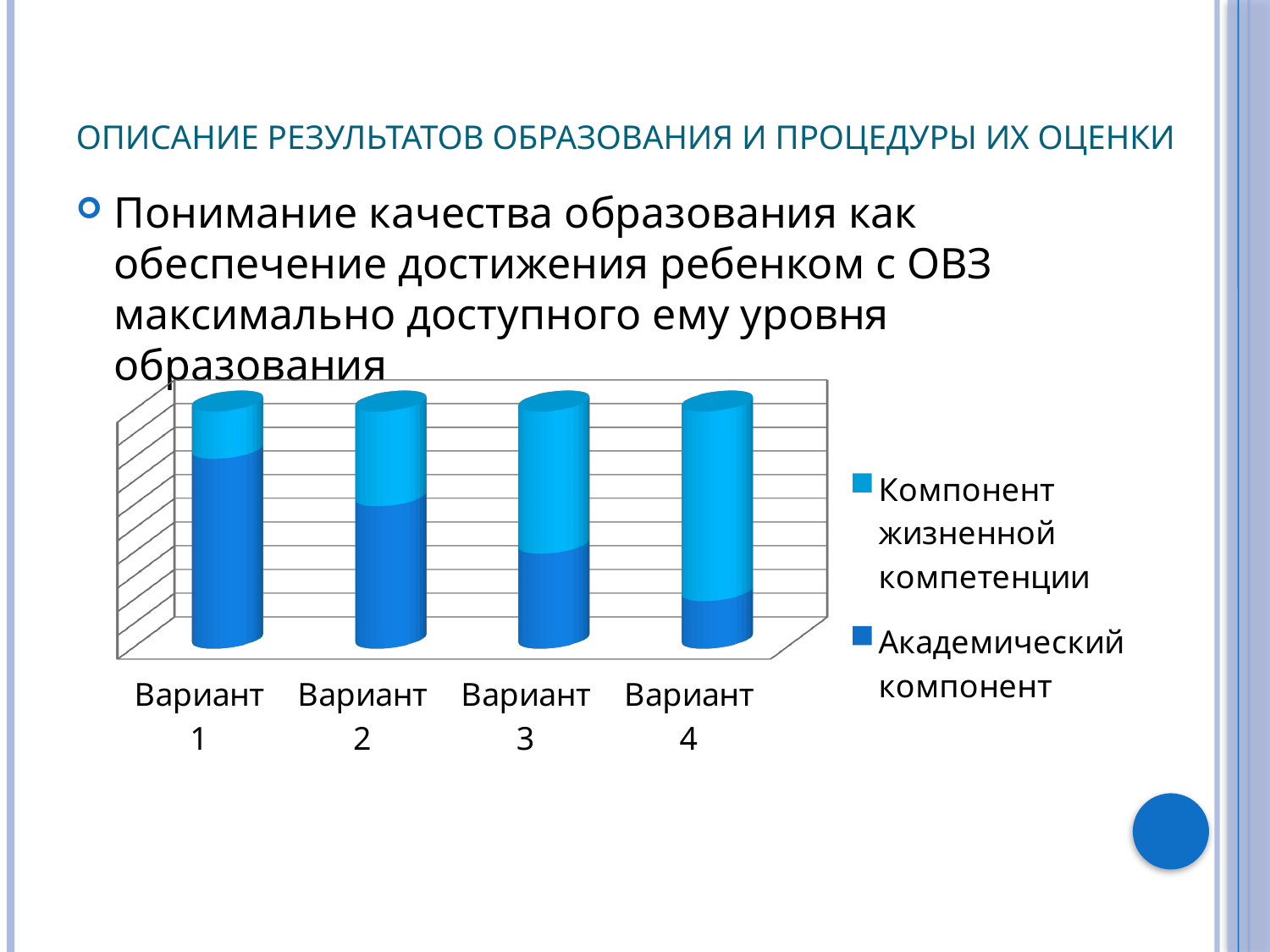
Does the Компонент жизненной компетенции segment rise or fall from Вариант 1 to Вариант 4? Rise What is the name of the series shown in light blue at the top of each bar? Компонент жизненной компетенции What kind of chart is shown on the slide? Stacked bar chart How many series does the chart legend list? 2 Which variant has the largest Академический компонент segment? Вариант 1 Which variant has the smallest Компонент жизненной компетенции segment? Вариант 1 Does the Академический компонент segment rise or fall from Вариант 1 to Вариант 4? Fall How many categories (variants) are shown on the x axis of the chart? 4 Is the Академический компонент segment larger in Вариант 2 or in Вариант 3? Вариант 2 Which series is shown in the darker blue colour at the bottom of each bar? Академический компонент Which variant has the smallest Академический компонент segment? Вариант 4 Which variant has the largest Компонент жизненной компетенции segment? Вариант 4